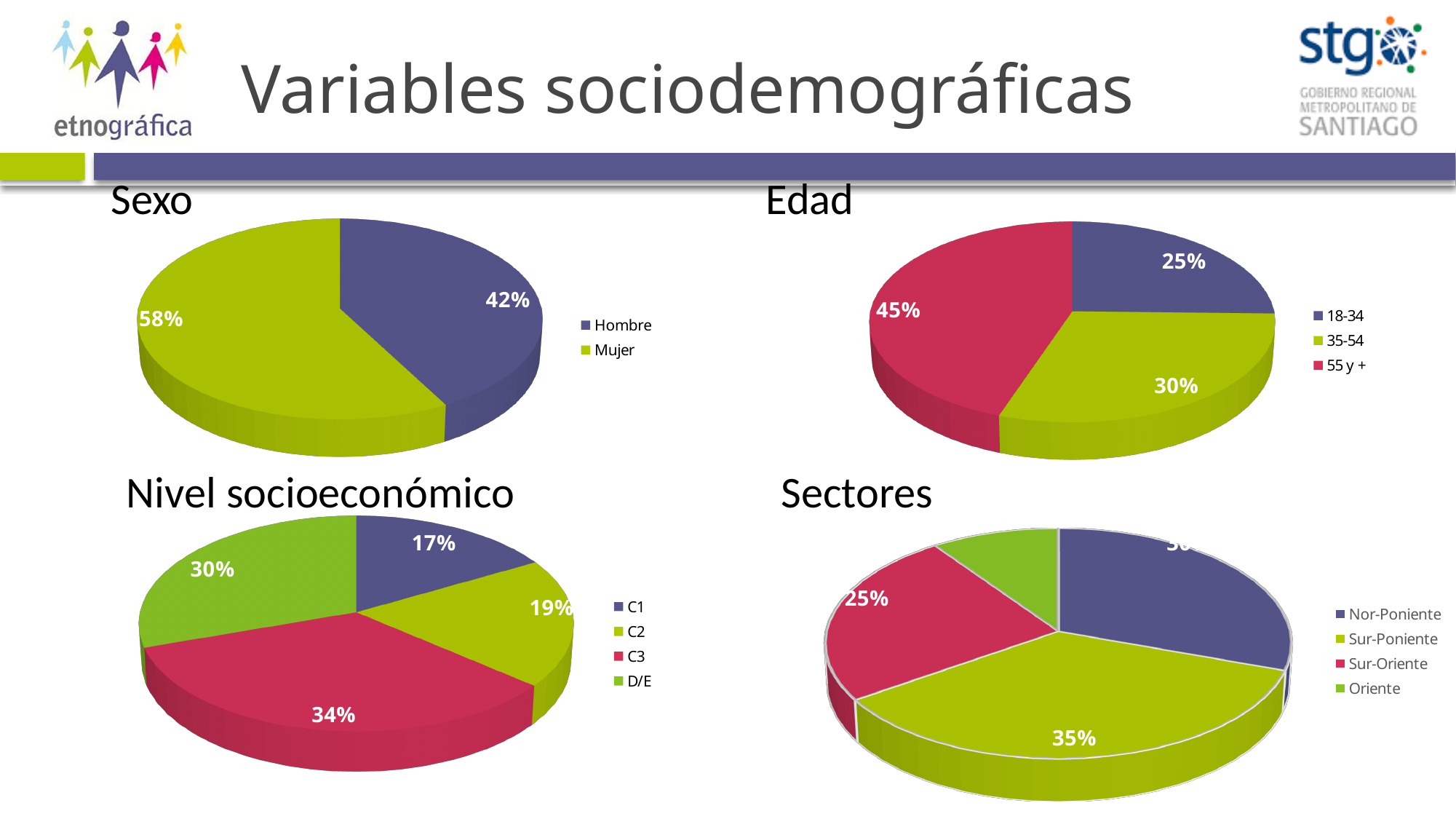
In the Nivel socioeconómico chart, how many categories does the legend list? 4 In the Sexo chart, what percentage is Mujer? 58% In the Edad chart, what is the difference between the 35-54 and 18-34 shares? 5% In the Nivel socioeconómico chart, which category has the smallest share? C1 What kind of chart is the Edad chart? Pie chart In the Sectores chart, what percentage is Sur-Poniente? 35% In the Nivel socioeconómico chart, what percentage is C3? 34% In the Edad chart, which age group has the smallest share? 18-34 In the Sexo chart, which category has the larger share? Mujer In the Sexo chart, what percentage is Hombre? 42% In the Sectores chart, which is larger, Sur-Poniente or Sur-Oriente? Sur-Poniente In the Edad chart, what percentage is the 55 y + group? 45%